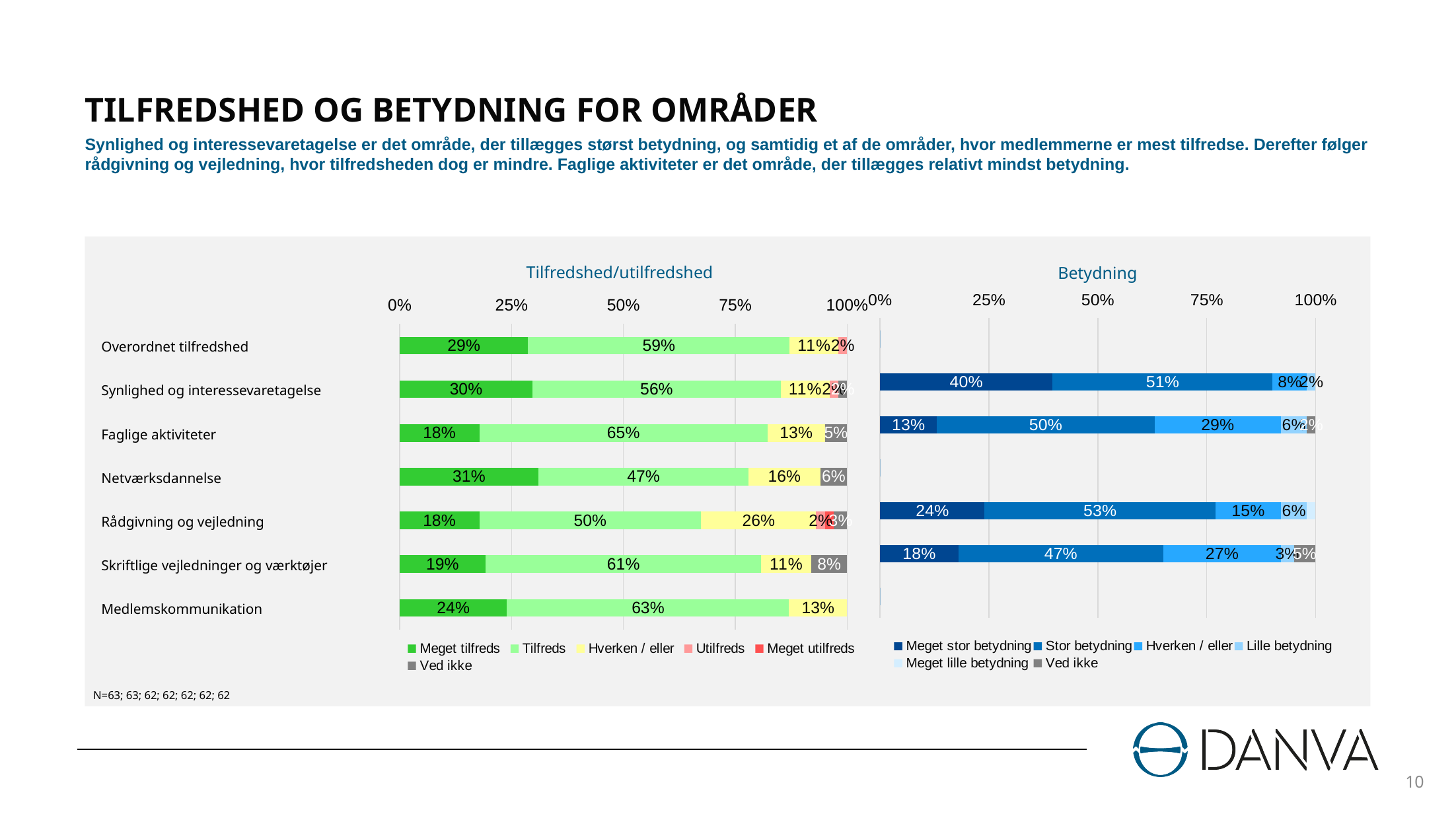
In the Tilfredshed/utilfredshed chart, what is the Tilfreds value for Faglige aktiviteter? 65% In the Betydning chart, what is the Meget stor betydning value for Synlighed og interessevaretagelse? 40% In the Tilfredshed/utilfredshed chart, which category has the lowest Tilfreds value? Netværksdannelse What kind of chart is the Tilfredshed/utilfredshed chart? Stacked bar chart In the Tilfredshed/utilfredshed chart, which category has the highest Meget tilfreds value? Netværksdannelse In the Tilfredshed/utilfredshed chart, what is the Hverken / eller value for Rådgivning og vejledning? 26% In the Tilfredshed/utilfredshed chart, what is the Meget tilfreds value for Netværksdannelse? 31% In the Betydning chart, which category has the highest Meget stor betydning value? Synlighed og interessevaretagelse In the Betydning chart, what is the Stor betydning value for Rådgivning og vejledning? 53% How many series does the legend of the Betydning chart list? 6 In the Tilfredshed/utilfredshed chart, how much larger is the Tilfreds value for Medlemskommunikation than for Overordnet tilfredshed? 4 percentage points In the Betydning chart, which is larger: the Hverken / eller value for Faglige aktiviteter or for Skriftlige vejledninger og værktøjer? Faglige aktiviteter